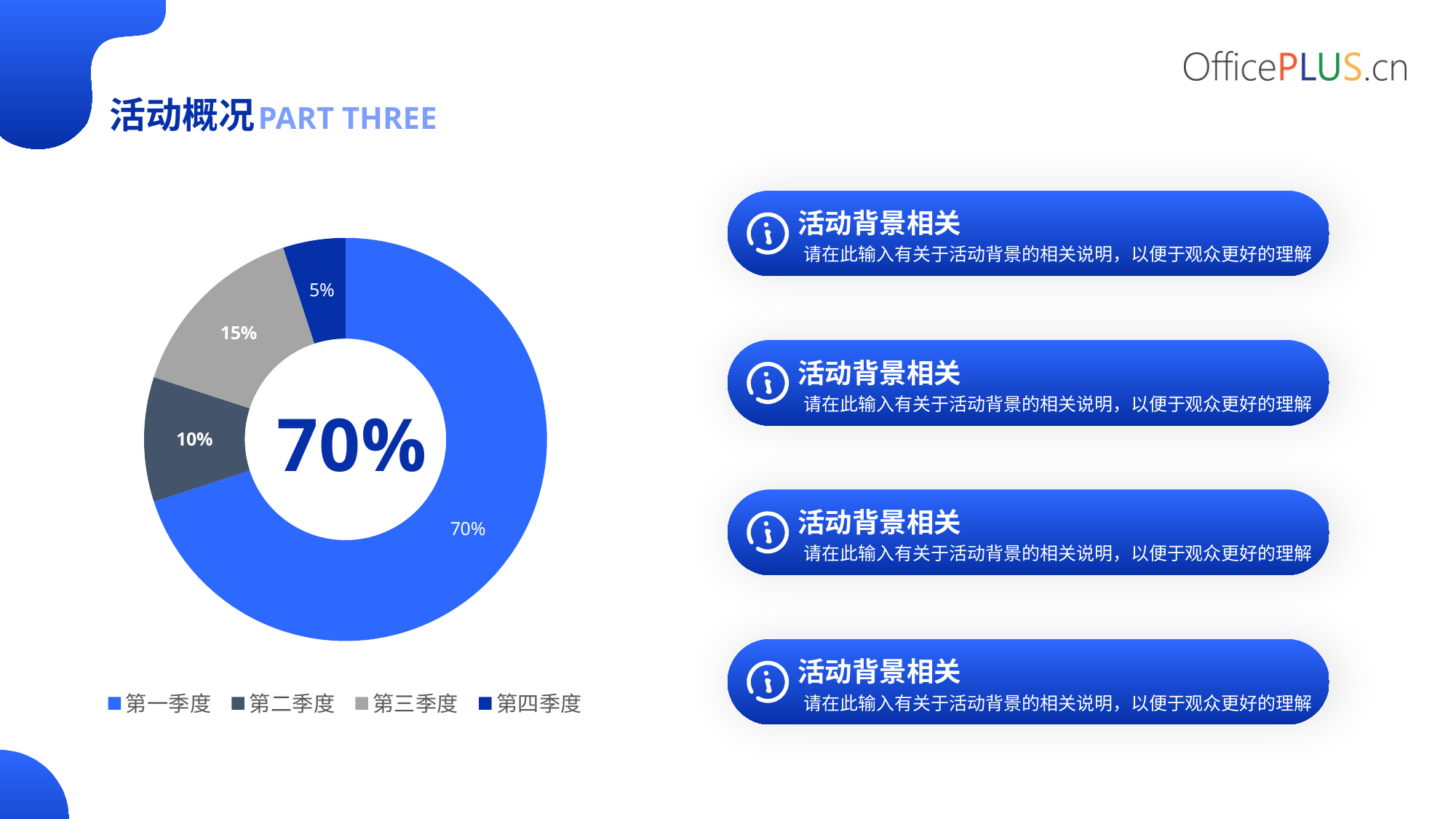
What number is displayed in the centre of the doughnut chart? 70% What is the value for 第四季度? 5% Which quarter has the largest share? 第一季度 What kind of chart is shown on the slide? Doughnut (pie) chart What is the difference between the values for 第一季度 and 第三季度? 55% Which quarter has the smallest share? 第四季度 What is the value for 第一季度? 70% What colour is the 第三季度 slice? Grey What is the value for 第二季度? 10% What is the value for 第三季度? 15% Which is larger, the value for 第二季度 or 第三季度? 第三季度 How many categories does the chart have? 4